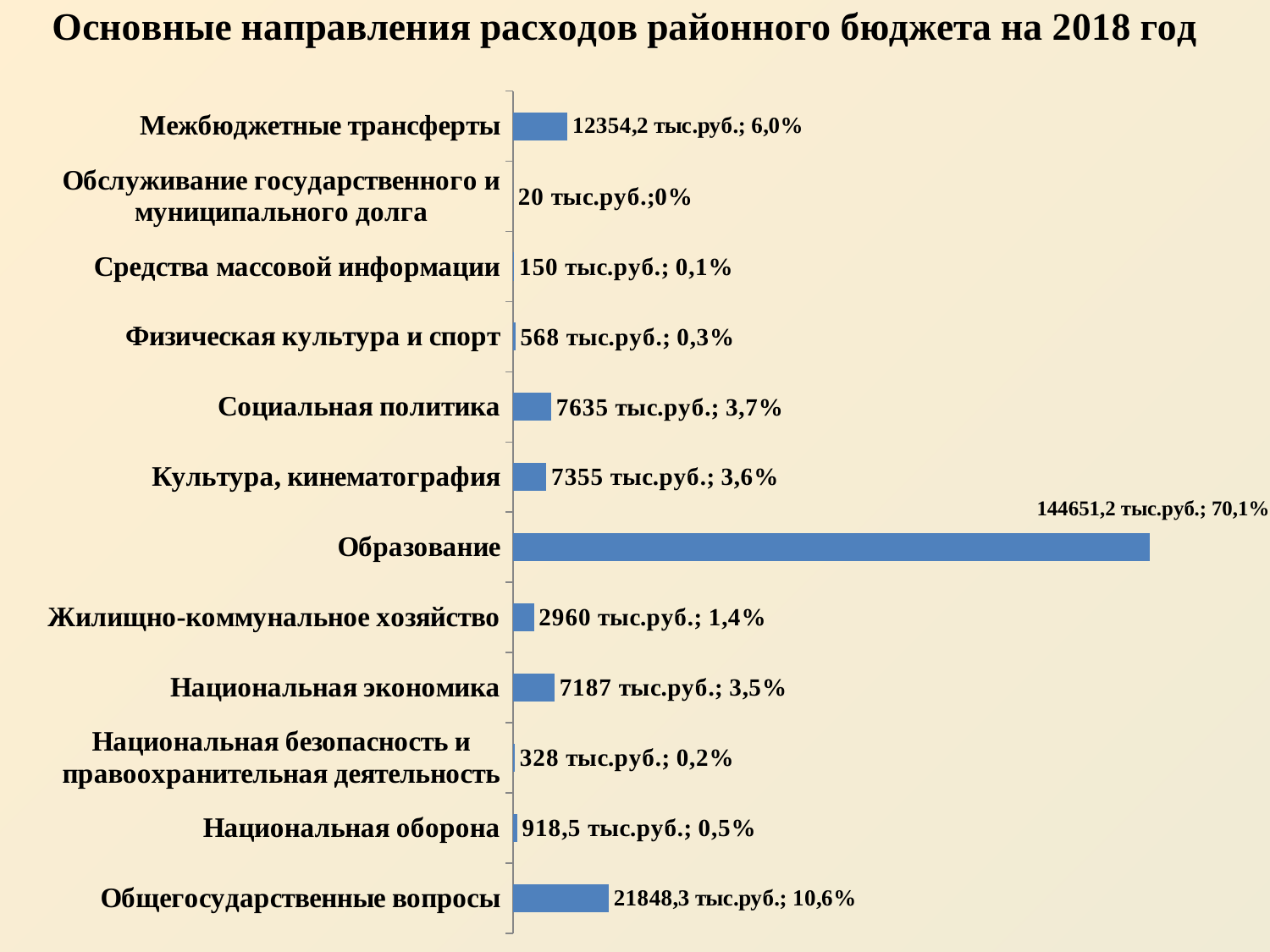
How many categories are shown in the chart? 12 What is the value in тыс.руб. for Национальная оборона? 918,5 тыс.руб. Which category has the highest value? Образование Which category has the lowest value? Обслуживание государственного и муниципального долга What is the difference in тыс.руб. between Социальная политика and Культура, кинематография? 280 тыс.руб. What is the difference in тыс.руб. between Общегосударственные вопросы and Межбюджетные трансферты? 9494,1 тыс.руб. Which is larger, Социальная политика or Национальная экономика? Социальная политика What is the value for Общегосударственные вопросы? 21848,3 тыс.руб.; 10,6% What is the value for Образование? 144651,2 тыс.руб.; 70,1% What type of chart is shown on the slide? Bar chart What is the title of the chart? Основные направления расходов районного бюджета на 2018 год What percentage share is shown for Межбюджетные трансферты? 6,0%